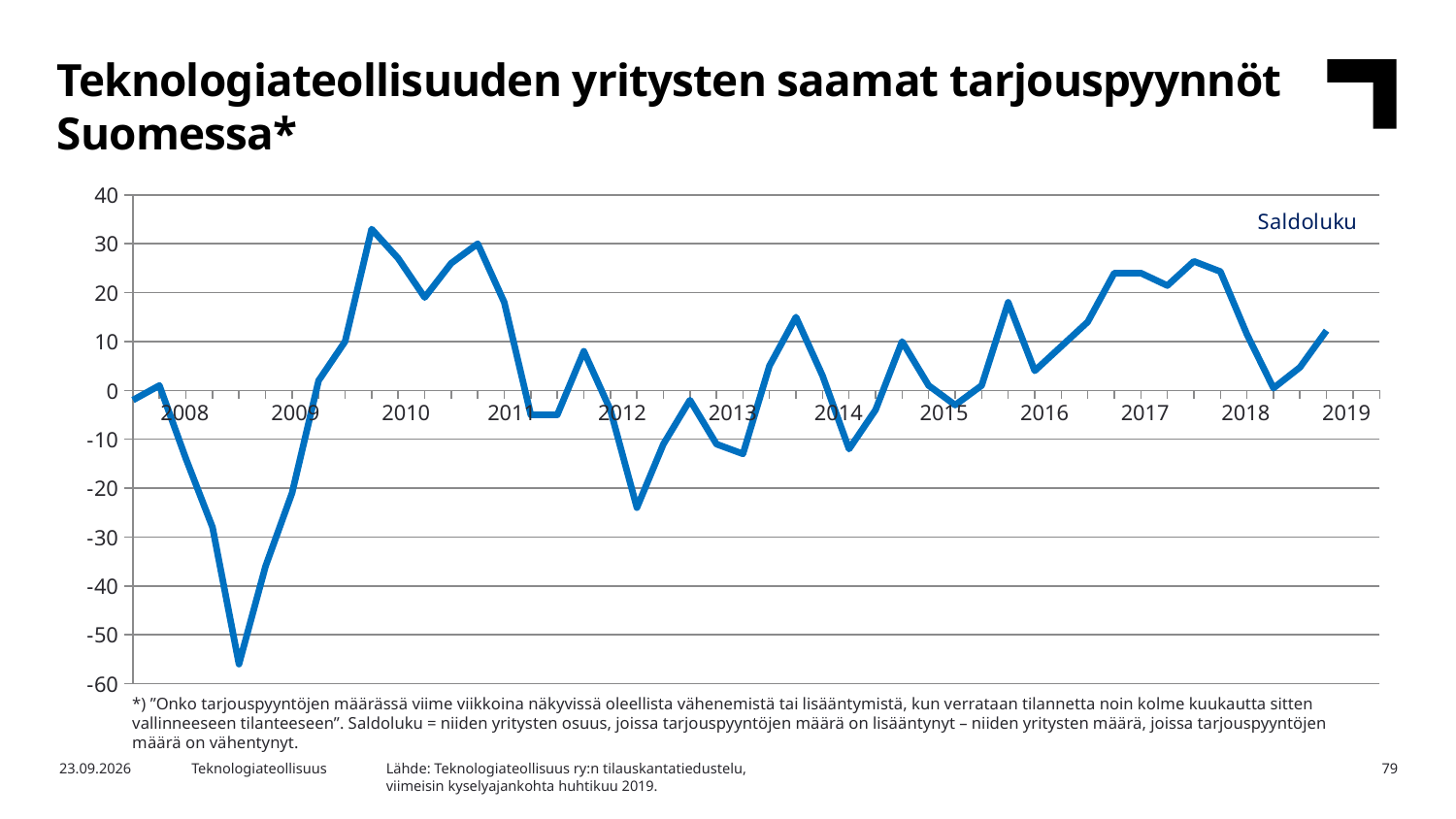
How many data series does the chart show? 1 What is the name of the series shown in the chart? Saldoluku Does the line rise or fall between the 2017 label and the 2018 label? fall Is the highest value of the line greater or less than 30? greater Does the line rise or fall between the 2015 label and the 2016 label? rise How many year labels are shown on the x axis? 12 What is the title of the chart on the slide? Teknologiateollisuuden yritysten saamat tarjouspyynnöt Suomessa* Is the value at the peak in 2017 greater or less than 20? greater What kind of chart is shown on the slide? line chart Is the last plotted value in 2019 greater or less than 0? greater